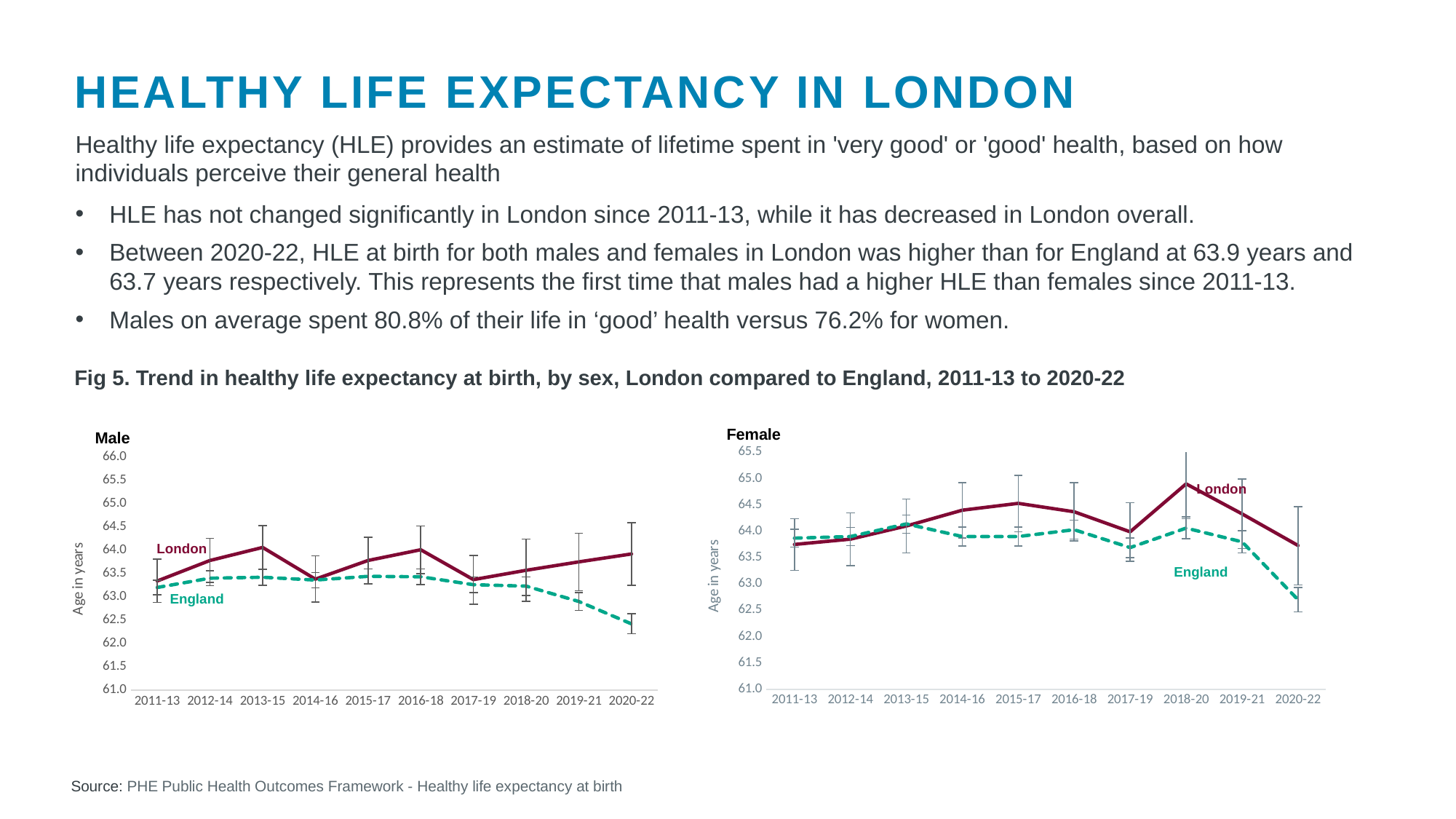
How many time periods are shown on the x axis of the Female chart? 10 On the Female chart, is the value for England in 2020-22 greater or less than 63.0? less On the Male chart, is the value for England in 2020-22 greater or less than 63.0? less What is the y-axis label on the Male chart? Age in years What kind of chart is the Male chart? line chart On the Male chart, which is larger in 2020-22, London or England? London On the Male chart, is the value for London in 2020-22 greater or less than 63.5? greater How many series are plotted on the Male chart? 2 On the Male chart, in which period is the England value lowest? 2020-22 On the Female chart, in which period is the London value highest? 2018-20 On the Female chart, does the England line rise or fall from 2018-20 to 2020-22? fall